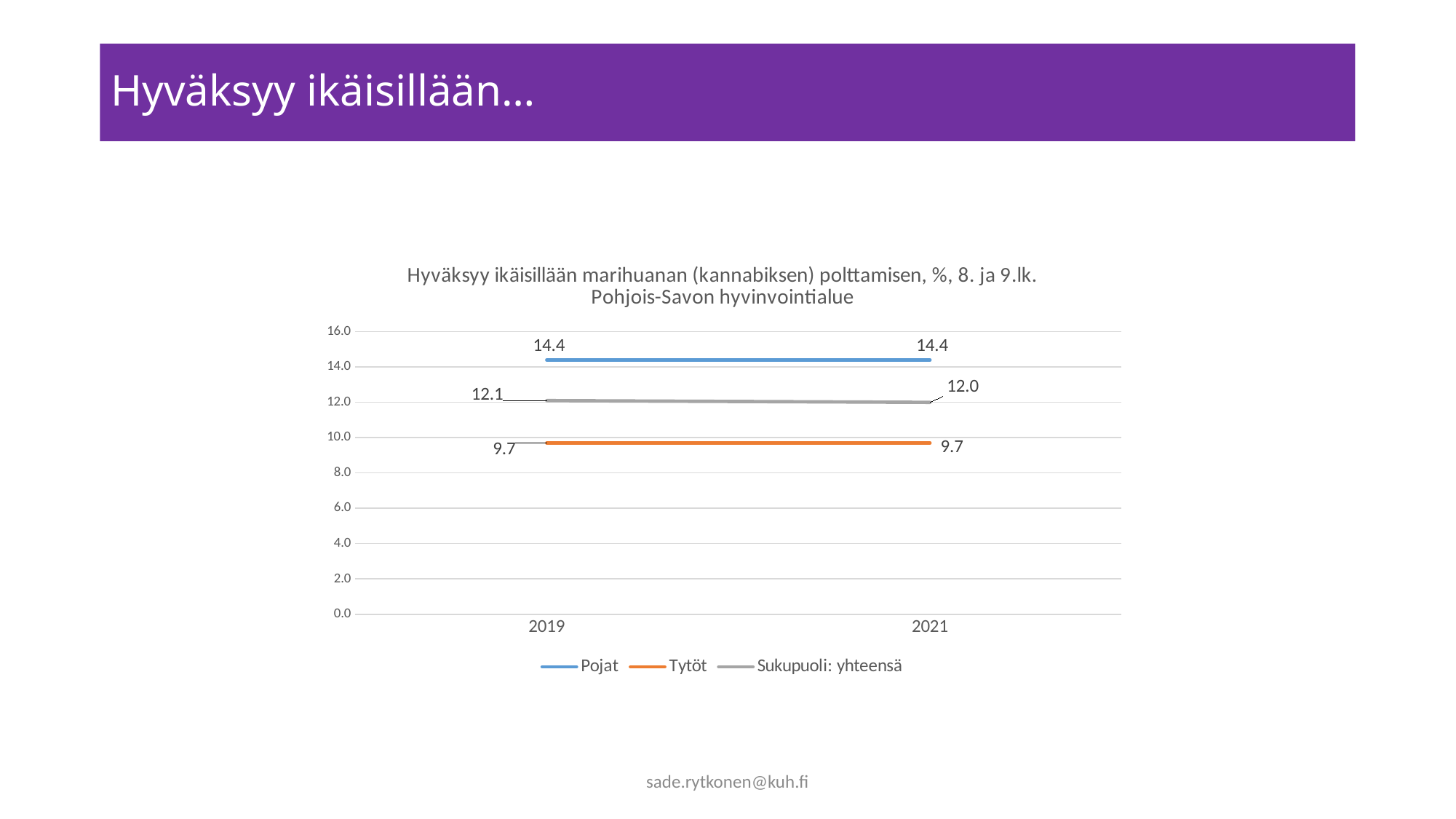
What kind of chart is shown on the slide? Line chart What is the value for Tytöt in 2021? 9.7 What is the difference between the Pojat and Tytöt values in 2019? 4.7 What is the value for Sukupuoli: yhteensä in 2019? 12.1 Which is larger in 2021, the value for Pojat or the value for Sukupuoli: yhteensä? Pojat Does the value for Sukupuoli: yhteensä rise or fall from 2019 to 2021? Fall Which series has the lowest value in 2019? Tytöt What is the value for Sukupuoli: yhteensä in 2021? 12.0 How many years are shown on the x axis? 2 How many series does the legend list? 3 Which series has the highest value in 2021? Pojat What is the value for Pojat in 2019? 14.4